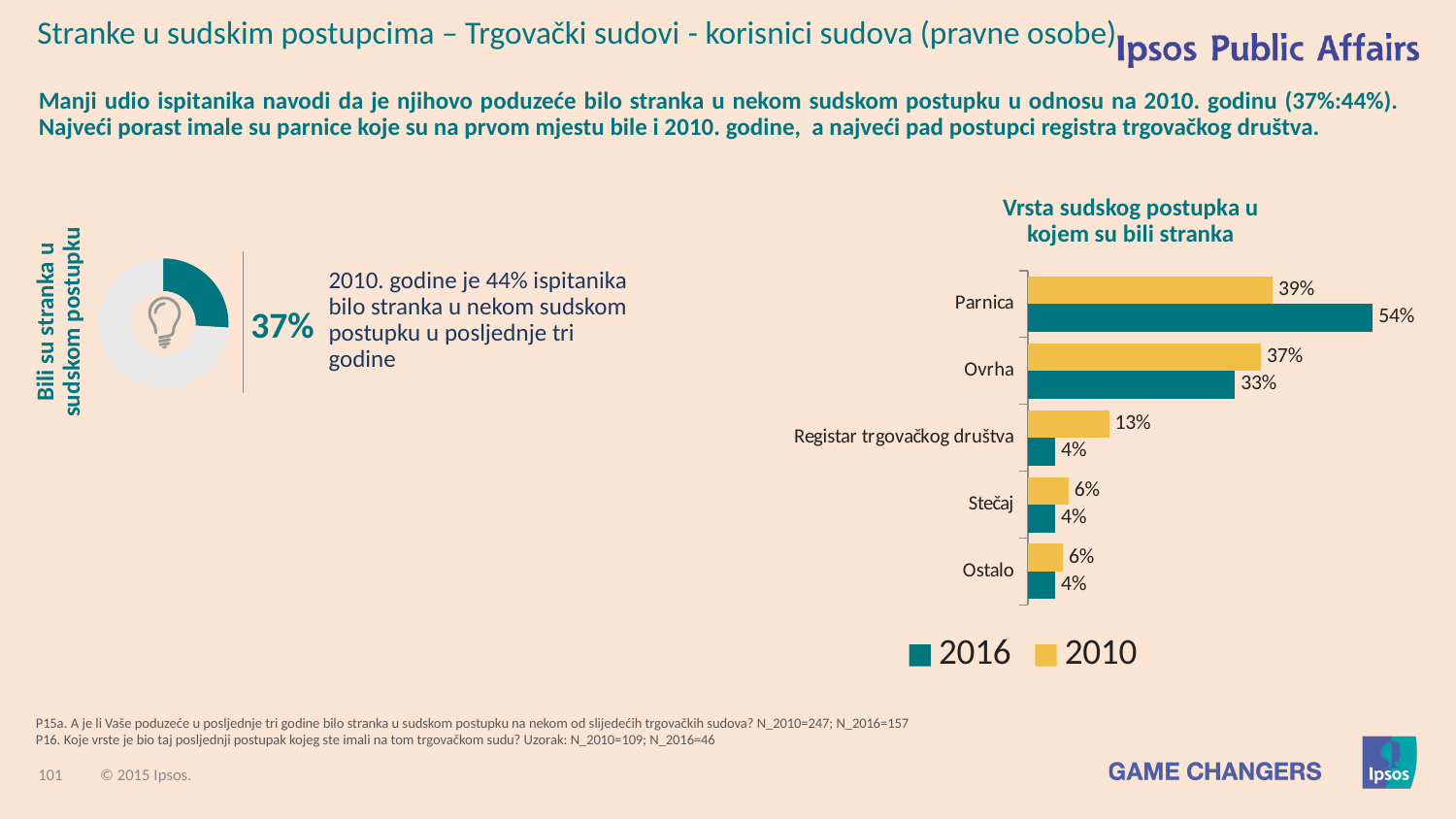
What type of chart is 'Vrsta sudskog postupka u kojem su bili stranka'? Bar chart How many series does the legend of the bar chart 'Vrsta sudskog postupka u kojem su bili stranka' list? 2 In the bar chart 'Vrsta sudskog postupka u kojem su bili stranka', is the 2010 value for Ovrha larger or smaller than the 2016 value for Ovrha? larger In the bar chart 'Vrsta sudskog postupka u kojem su bili stranka', which category has the lowest 2010 value? Stečaj and Ostalo (6%) In the bar chart 'Vrsta sudskog postupka u kojem su bili stranka', what is the 2016 value for Parnica? 54% In the bar chart 'Vrsta sudskog postupka u kojem su bili stranka', what is the 2010 value for Registar trgovačkog društva? 13% What percentage is shown in the donut chart on the left of the slide ('Bili su stranka u sudskom postupku')? 37% In the bar chart 'Vrsta sudskog postupka u kojem su bili stranka', what is the difference between the 2016 and 2010 values for Parnica? 15 percentage points In the bar chart 'Vrsta sudskog postupka u kojem su bili stranka', what is the 2010 value for Ovrha? 37% In the bar chart 'Vrsta sudskog postupka u kojem su bili stranka', what is the difference between the 2010 and 2016 values for Registar trgovačkog društva? 9 percentage points In the bar chart 'Vrsta sudskog postupka u kojem su bili stranka', which category has the highest 2016 value? Parnica How many categories are shown in the bar chart 'Vrsta sudskog postupka u kojem su bili stranka'? 5